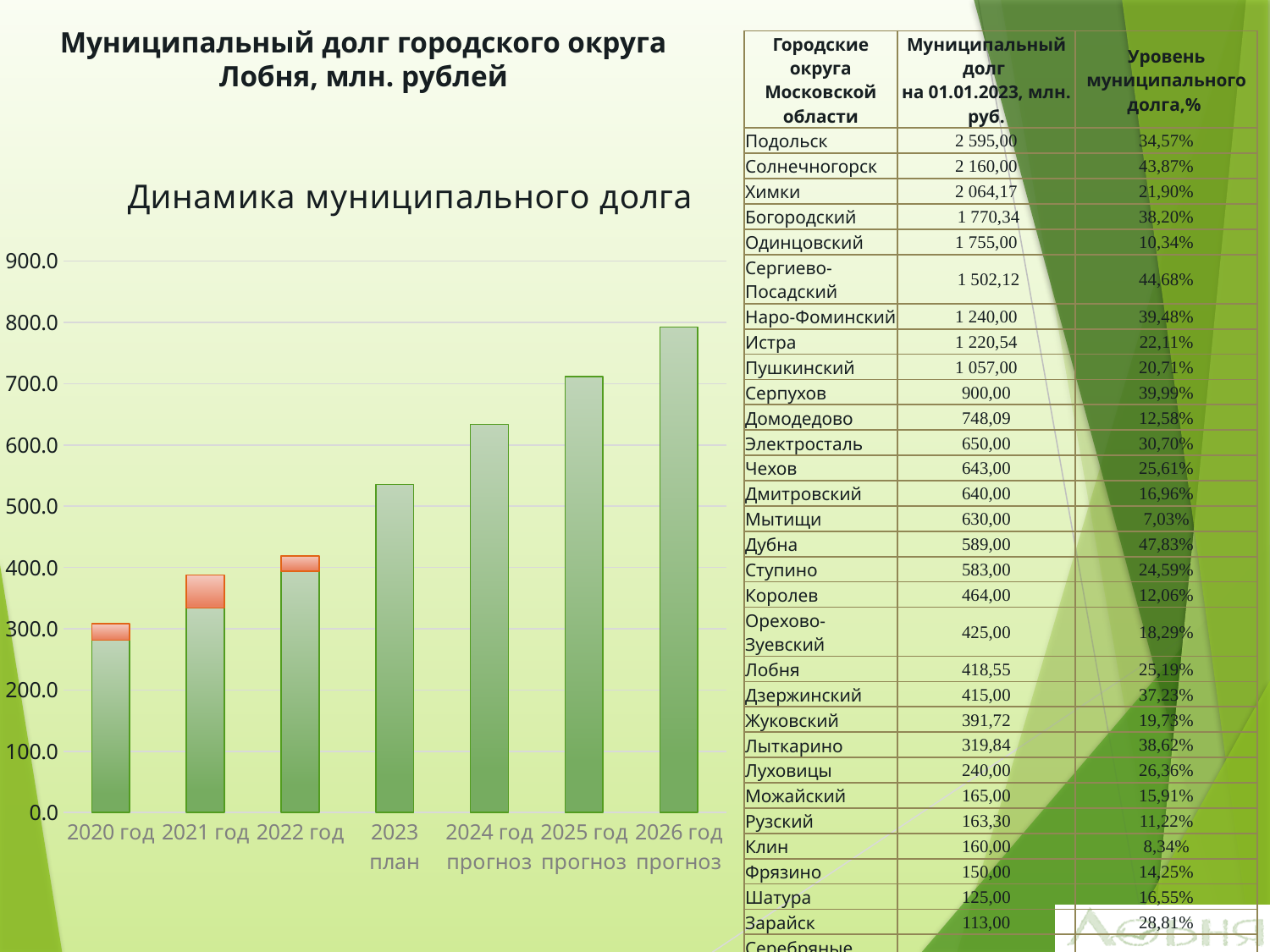
Which category has the lowest bar in the chart? 2020 год How many categories (years) are shown on the x axis of the chart? 7 Which is larger, the bar for 2025 год прогноз or the bar for 2023 план? 2025 год прогноз What is the title of the chart? Динамика муниципального долга What kind of chart is shown on the slide? bar chart Is the value for 2026 год прогноз greater or less than 700.0? greater Is the value for 2024 год прогноз greater or less than 700.0? less Is the value for 2023 план greater or less than 500.0? greater Which category has the highest bar in the chart? 2026 год прогноз Which bars in the chart include an orange segment on top? 2020 год, 2021 год, 2022 год Do the bar values rise or fall from 2020 год to 2026 год прогноз? rise